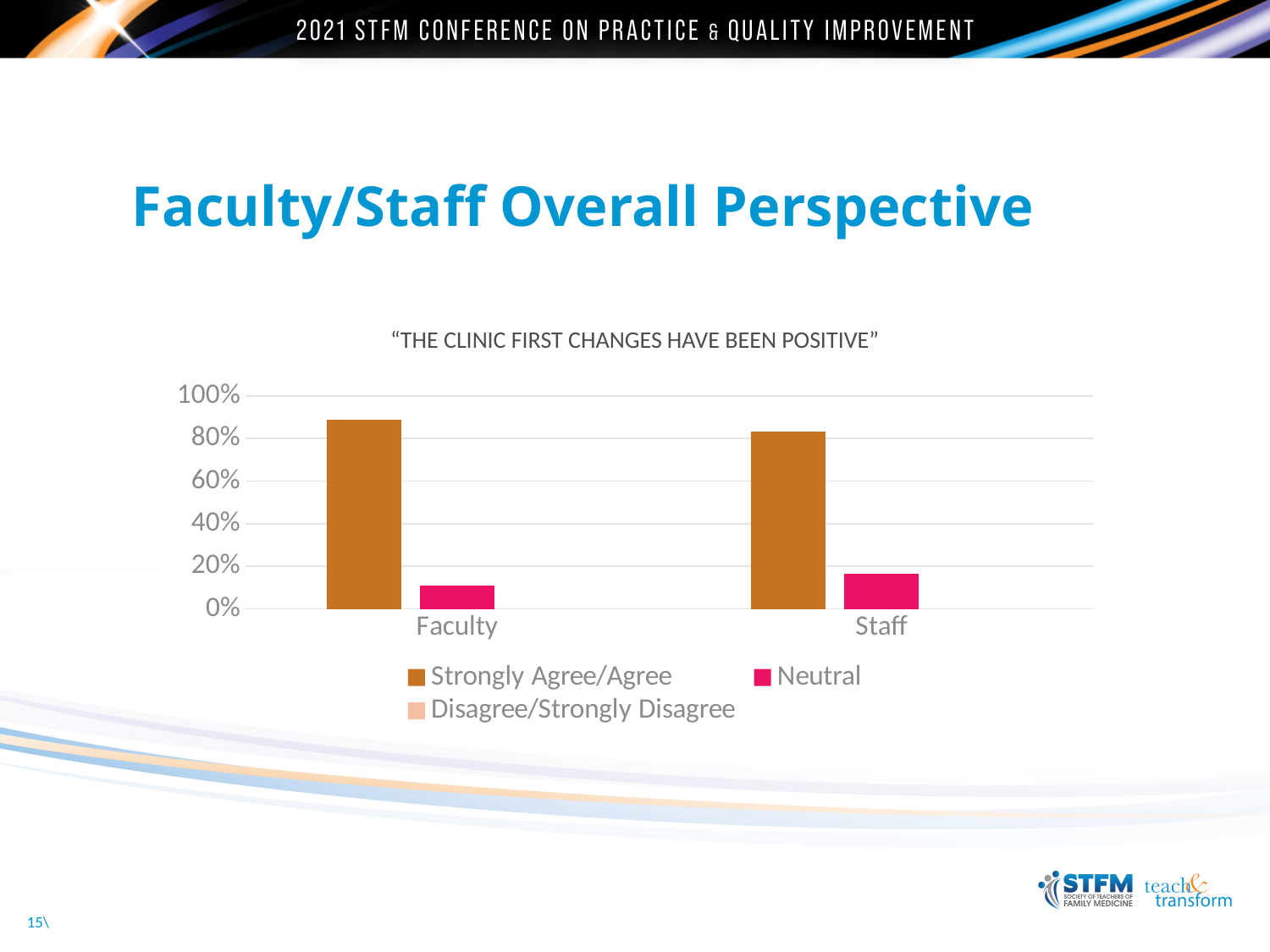
Is the Neutral value for Faculty greater or less than 20%? less How many categories are shown on the x axis of the chart? 2 Which category has the higher Strongly Agree/Agree value, Faculty or Staff? Faculty Is the Strongly Agree/Agree value for Faculty greater or less than 80%? greater For Faculty, which series has the highest bar? Strongly Agree/Agree How many series does the chart's legend list? 3 Which category has the higher Neutral value, Faculty or Staff? Staff Which legend entry is shown in pink? Neutral Is the Strongly Agree/Agree value for Staff greater or less than 80%? greater What is the title of the chart? "THE CLINIC FIRST CHANGES HAVE BEEN POSITIVE" What kind of chart is shown on the slide? bar chart